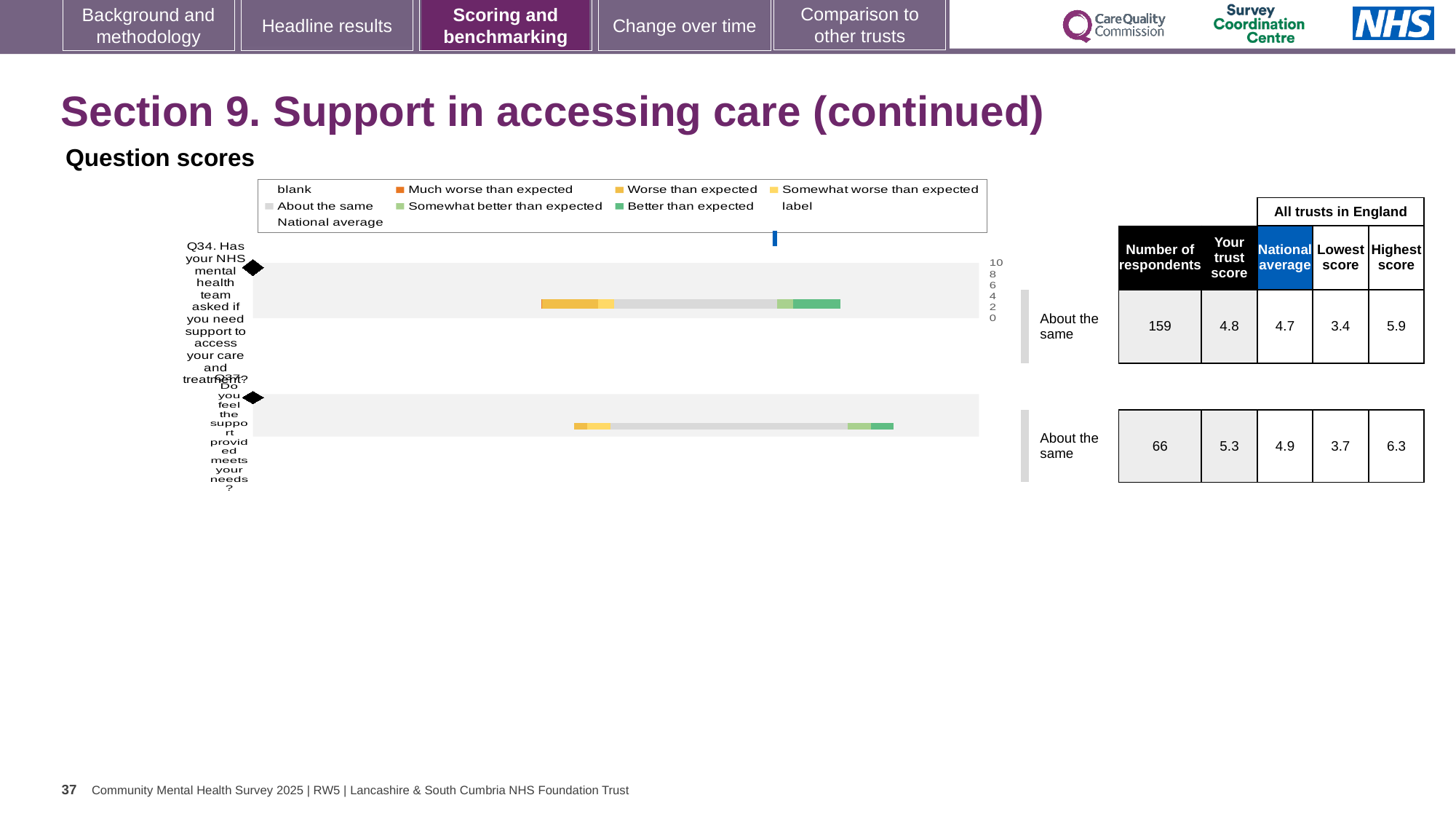
What is the difference between the highest and lowest scores across all trusts in England for Q37? 2.6 What is the difference between the trust score and the national average for Q37? 0.4 What is the trust score for Q34 (Has your NHS mental health team asked if you need support to access your care and treatment)? 4.8 What is the national average score for Q37 (Do you feel the support provided meets your needs)? 4.9 What kind of chart is used to show the question scores on this slide? bar chart Which question has the higher trust score, Q34 or Q37? Q37 How many questions are plotted in the question scores chart? 2 What benchmark category is shown for Q34 in the question scores chart? About the same How many respondents answered Q34? 159 Which question has more respondents, Q34 or Q37? Q34 What is the highest score among all trusts in England for Q37? 6.3 What is the lowest score among all trusts in England for Q34? 3.4